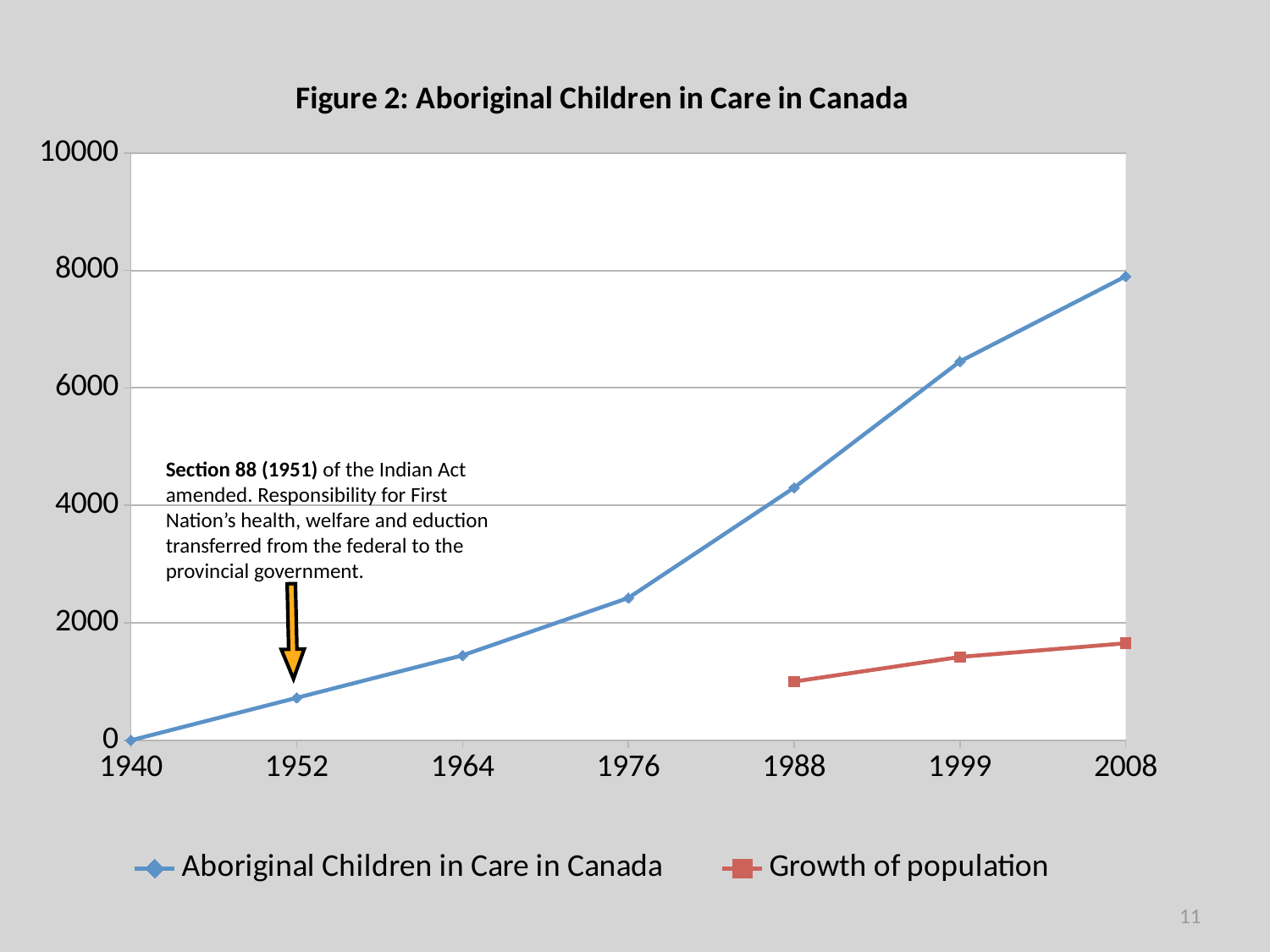
Is the value for Aboriginal Children in Care in Canada in 1976 greater or less than 4000? less Which series is drawn in red with square markers? Growth of population Is the value for Aboriginal Children in Care in Canada in 2008 greater or less than 6000? greater Is the value for Growth of population in 2008 greater or less than 2000? less What type of chart is shown on the slide? line chart In which year is the value for Aboriginal Children in Care in Canada lowest? 1940 What is the title of the chart? Figure 2: Aboriginal Children in Care in Canada How many series does the legend list? 2 How many years are labelled along the x axis? 7 In 1999, which series has the larger value: Aboriginal Children in Care in Canada or Growth of population? Aboriginal Children in Care in Canada Does the Aboriginal Children in Care in Canada series rise or fall from 1940 to 2008? rise In which year is the value for Aboriginal Children in Care in Canada highest? 2008